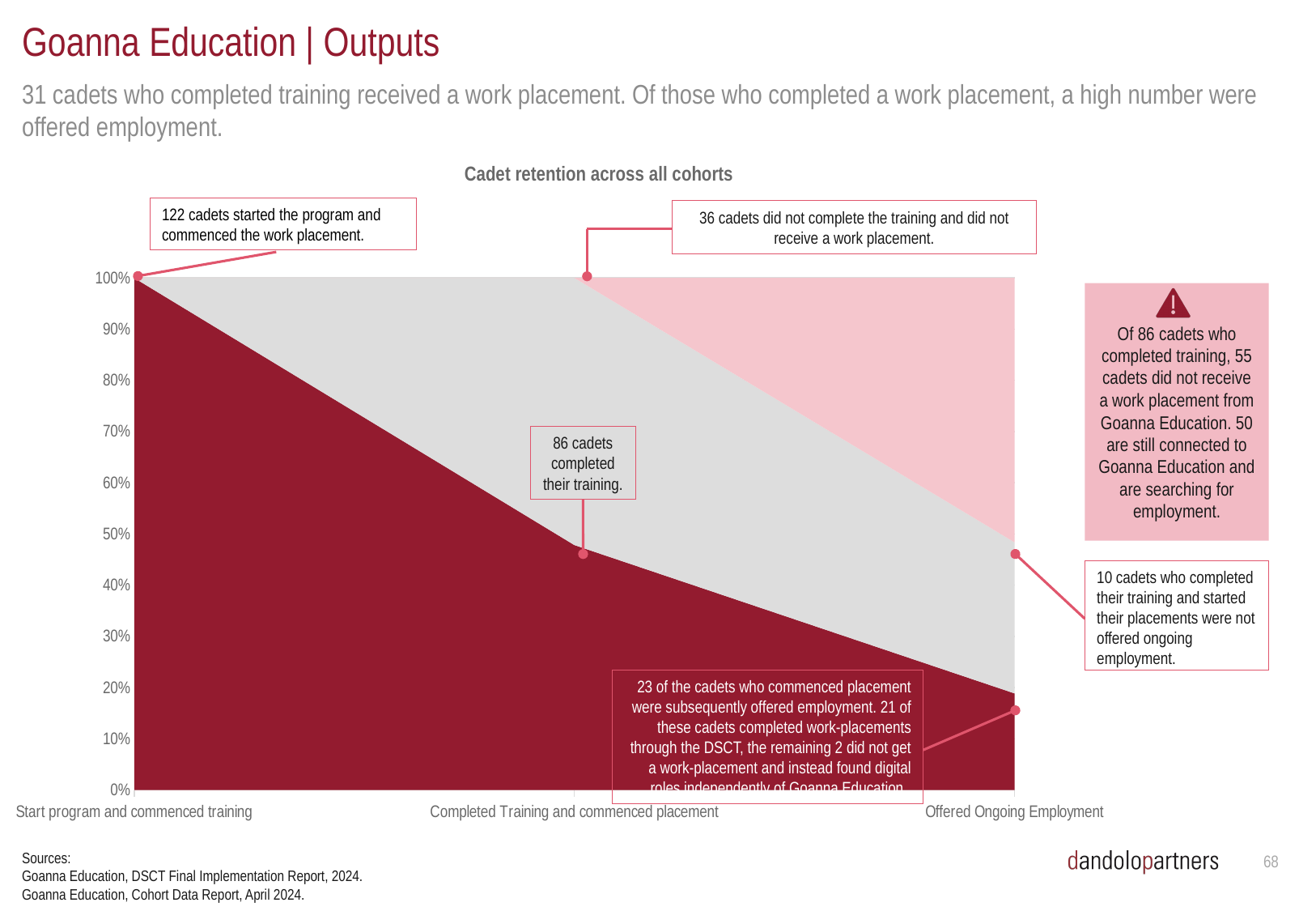
At which x-axis category is the dark red area highest? Start program and commenced training What kind of chart is shown on the slide? area chart What is the title of the chart? Cadet retention across all cohorts According to the chart annotation, how many cadets completed their training? 86 Is the dark red area's value at 'Offered Ongoing Employment' greater or less than 20%? less How many categories are shown along the x axis of the chart? 3 According to the chart annotation, how many cadets who completed their training and started their placements were not offered ongoing employment? 10 Which is larger for the dark red area: the value at 'Start program and commenced training' or at 'Offered Ongoing Employment'? Start program and commenced training According to the chart annotation, how many cadets did not complete the training and did not receive a work placement? 36 Does the dark red area rise or fall from left to right along the x axis? fall Is the dark red area's value at 'Completed Training and commenced placement' greater or less than 50%? less According to the chart annotation, how many cadets started the program and commenced the work placement? 122